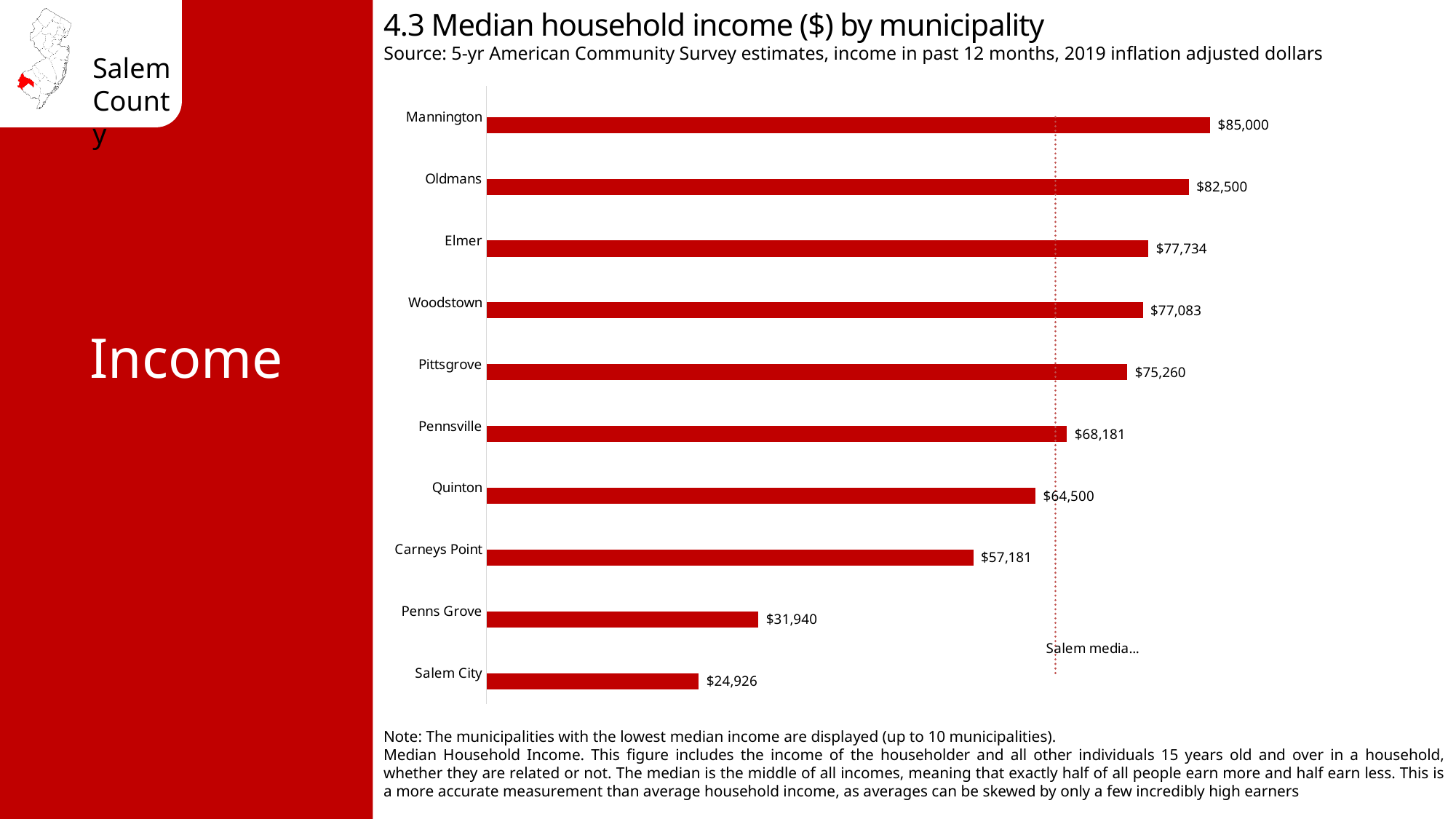
Which municipality has the highest median household income on the chart? Mannington Which has a higher median household income, Quinton or Carneys Point? Quinton What is the difference in median household income between Carneys Point and Penns Grove? $25,241 What kind of chart is used to show median household income by municipality? Bar chart What is the difference in median household income between Mannington and Oldmans? $2,500 What is the median household income for Mannington? $85,000 Which municipality has the lowest median household income on the chart? Salem City What does the dotted vertical line on the chart represent? Salem median Which has a higher median household income, Elmer or Pittsgrove? Elmer What is the median household income for Penns Grove? $31,940 What is the median household income for Pennsville? $68,181 How many municipalities are shown on the chart? 10